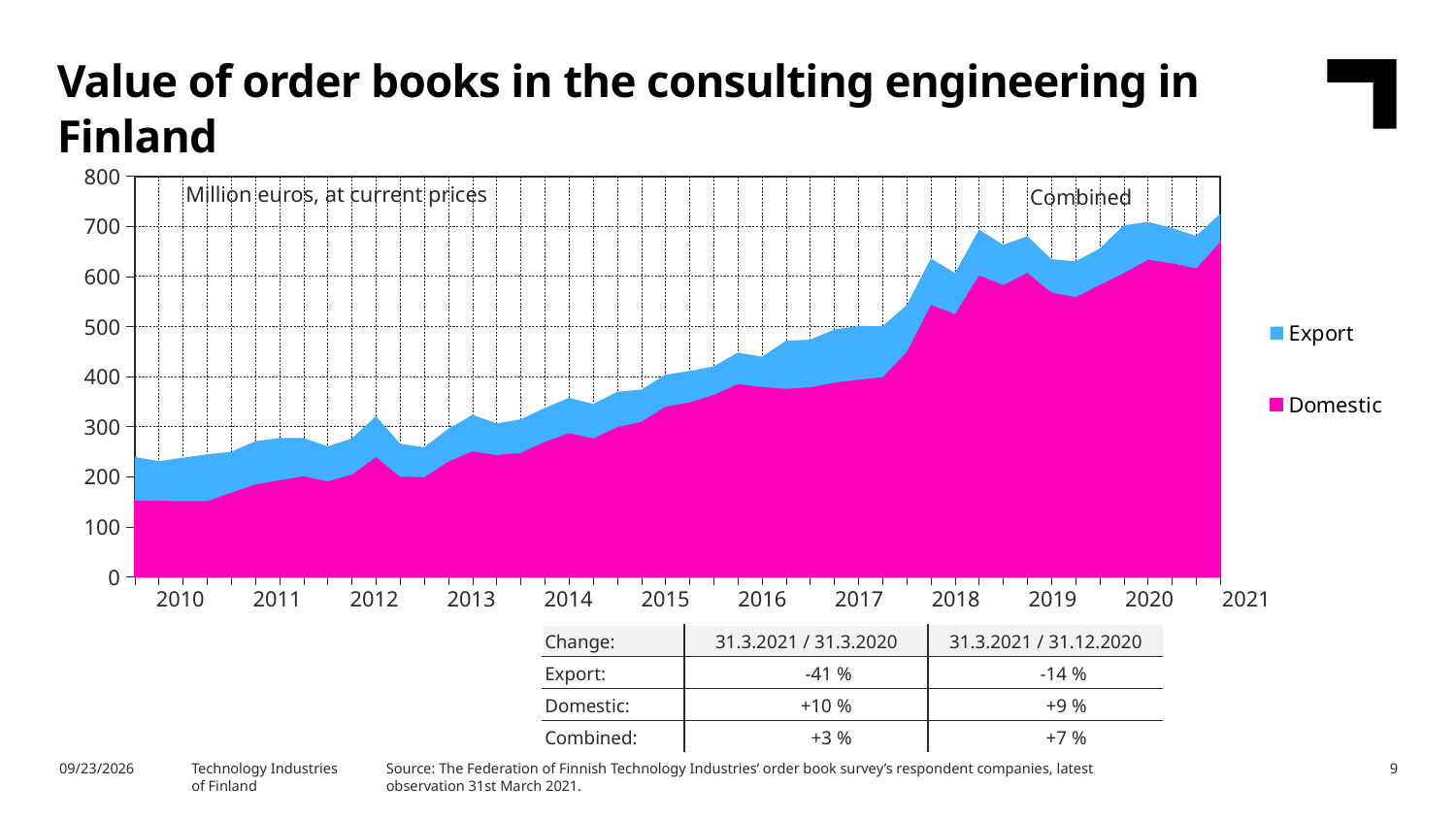
According to the table below the chart, what is the change in Export order books for 31.3.2021 / 31.3.2020? -41 % What unit is stated in the label at the top left of the chart? Million euros, at current prices How many series does the chart legend list? 2 Is the combined value at the start of 2010 greater or less than 300? less Is the combined value at the end of the series in 2021 greater or less than 700? greater Which two series are listed in the chart legend? Export and Domestic Is the Domestic value at the start of 2010 greater or less than 200? less How many year labels are shown on the x axis? 12 Does the combined value of order books generally rise or fall from 2010 to 2021? Rise What kind of chart is shown on the slide? Stacked area chart According to the table below the chart, what is the change in Combined order books for 31.3.2021 / 31.12.2020? +7 %